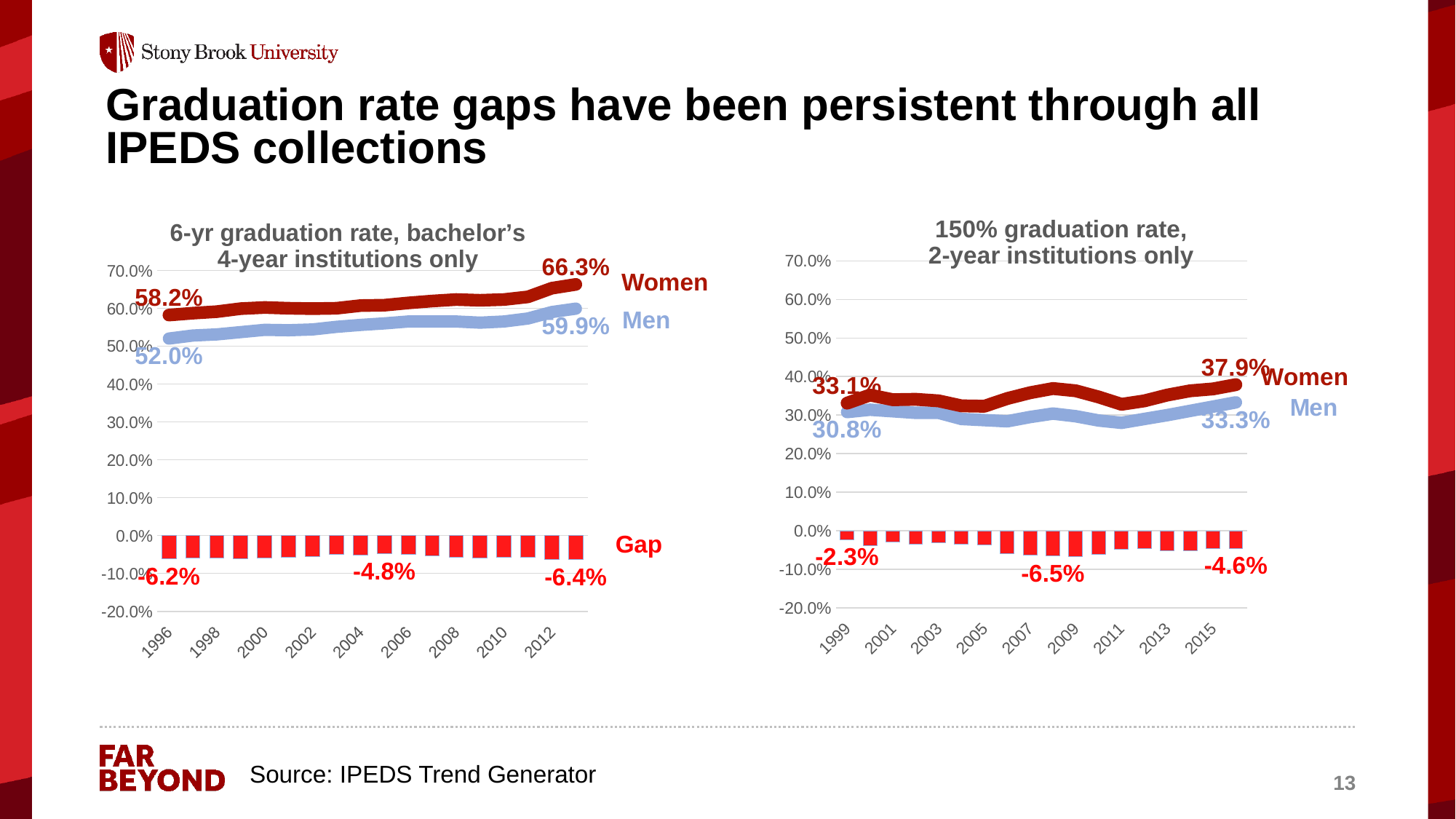
In the right chart (150% graduation rate, 2-year institutions only), what is the Men value in 1999? 30.8% In the left chart (6-yr graduation rate, bachelor's 4-year institutions only), does the Women series rise or fall from 1996 to the end of the period? rise In the left chart (6-yr graduation rate, bachelor's 4-year institutions only), what is the final labelled Women value? 66.3% In the left chart (6-yr graduation rate, bachelor's 4-year institutions only), what is the final labelled Men value? 59.9% In the left chart (6-yr graduation rate, bachelor's 4-year institutions only), what is the Women value at the start of the series in 1996? 58.2% In the right chart (150% graduation rate, 2-year institutions only), what is the final labelled Women value? 37.9% In the left chart (6-yr graduation rate, bachelor's 4-year institutions only), which series is higher at the end of the period, Women or Men? Women In the right chart (150% graduation rate, 2-year institutions only), is the Women value in 2009 greater or less than 40%? less In the right chart (150% graduation rate, 2-year institutions only), what is the final labelled Gap value? -4.6% In the right chart (150% graduation rate, 2-year institutions only), what is the Women value in 1999? 33.1% In the left chart (6-yr graduation rate, bachelor's 4-year institutions only), what is the Men value at the start of the series in 1996? 52.0% In the left chart (6-yr graduation rate, bachelor's 4-year institutions only), what is the difference between the Women and Men values in 1996? 6.2%